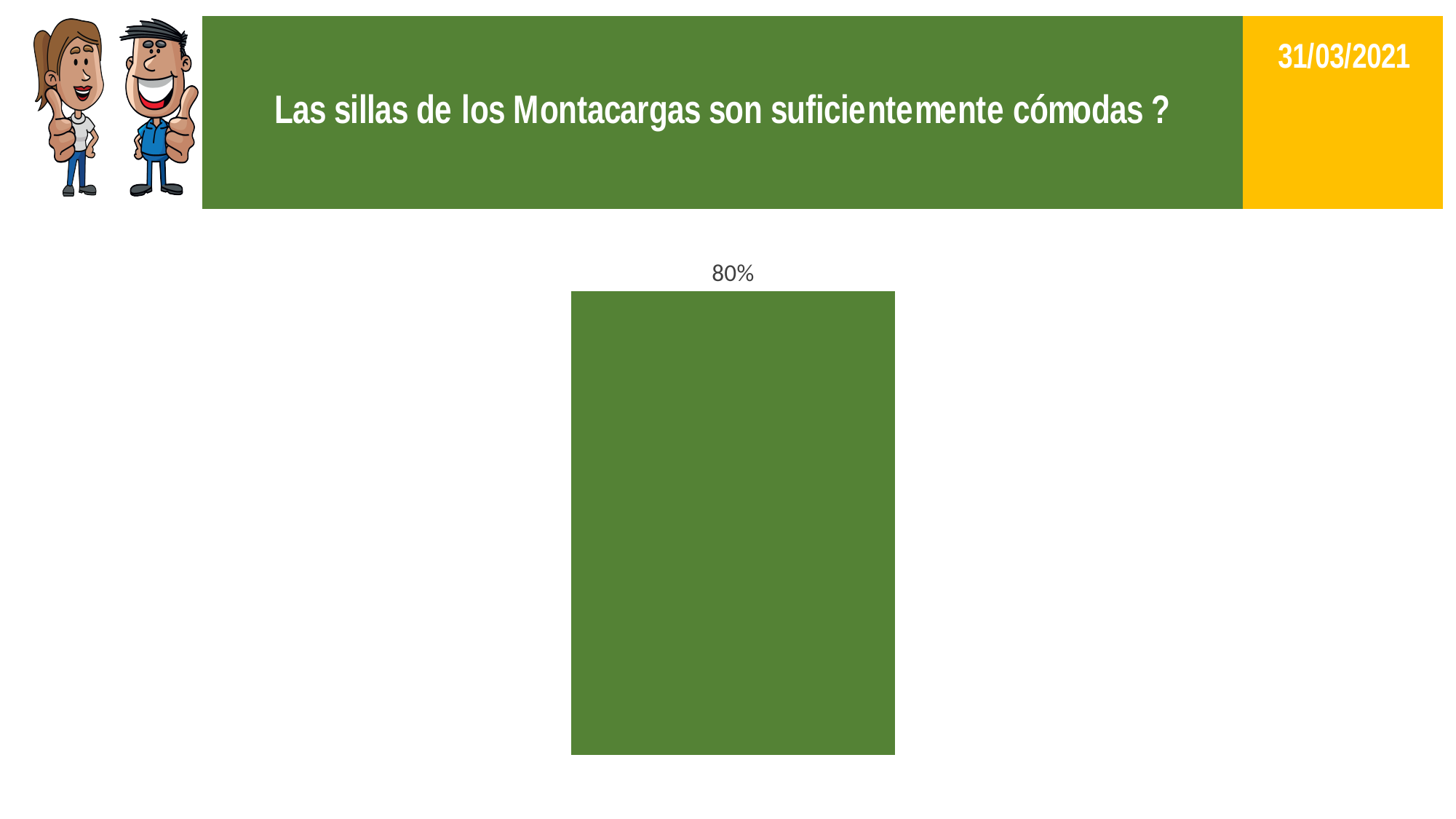
How many bars are plotted in the chart? 1 What question does the slide title ask about the chart's data? Las sillas de los Montacargas son suficientemente cómodas ? What colour is the bar in the chart? green What kind of chart is shown on the slide? bar chart What value is shown on the data label of the bar in the chart? 80%